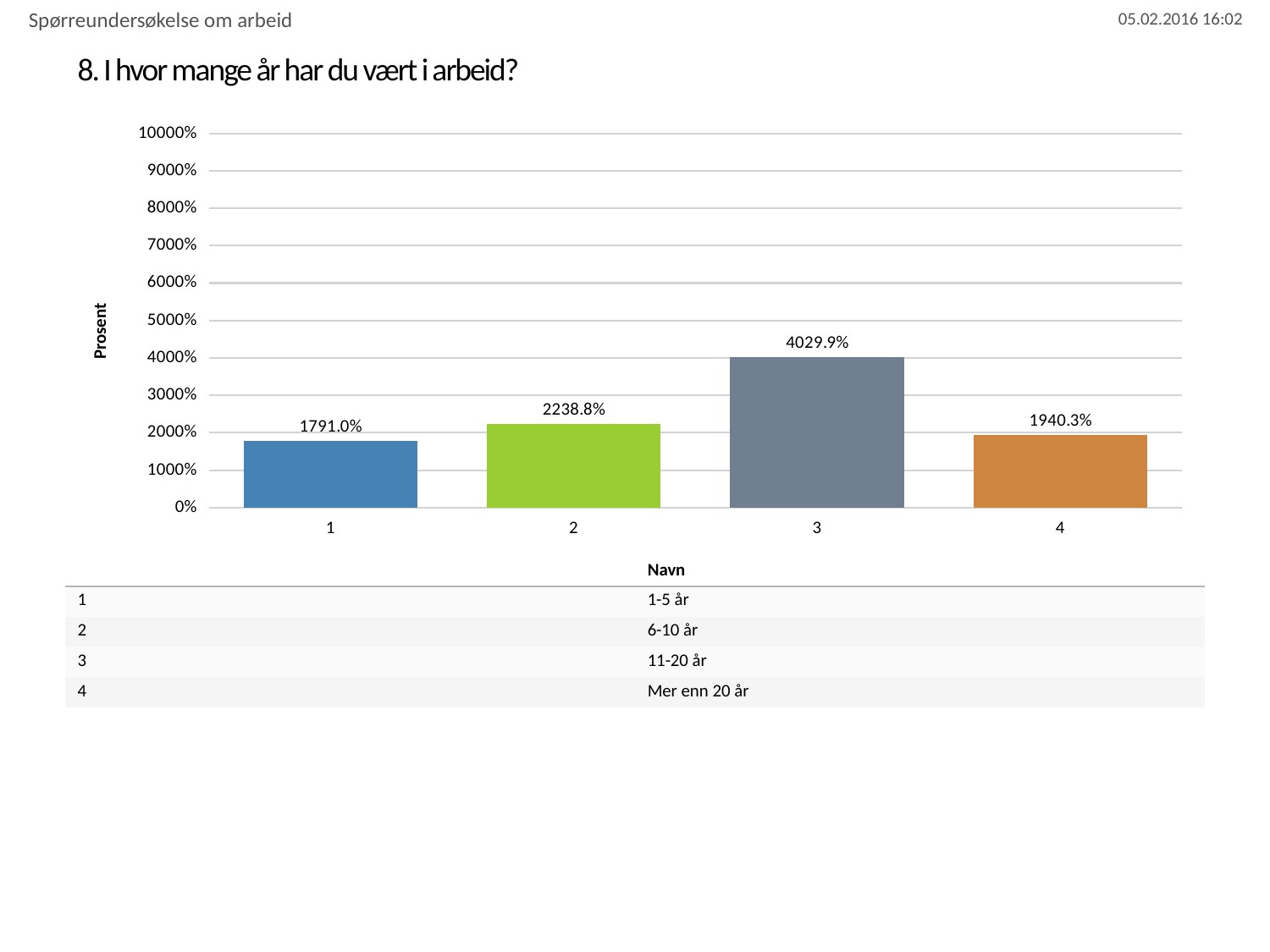
Which category has the highest value? 3 (11-20 år) What is the difference between the values for category 3 and category 2? 1791.1% What is the value for category 3 (11-20 år)? 4029.9% What is the value for category 1 (1-5 år)? 1791.0% Which is larger, the value for category 2 or the value for category 4? Category 2 Is the value for category 3 greater or less than 3000%? greater Which category has the lowest value? 1 (1-5 år) What is the value for category 2 (6-10 år)? 2238.8% What is the value for category 4 (Mer enn 20 år)? 1940.3% What kind of chart is shown on the slide? Bar chart How many categories are shown in the chart? 4 What is the label of the y axis? Prosent